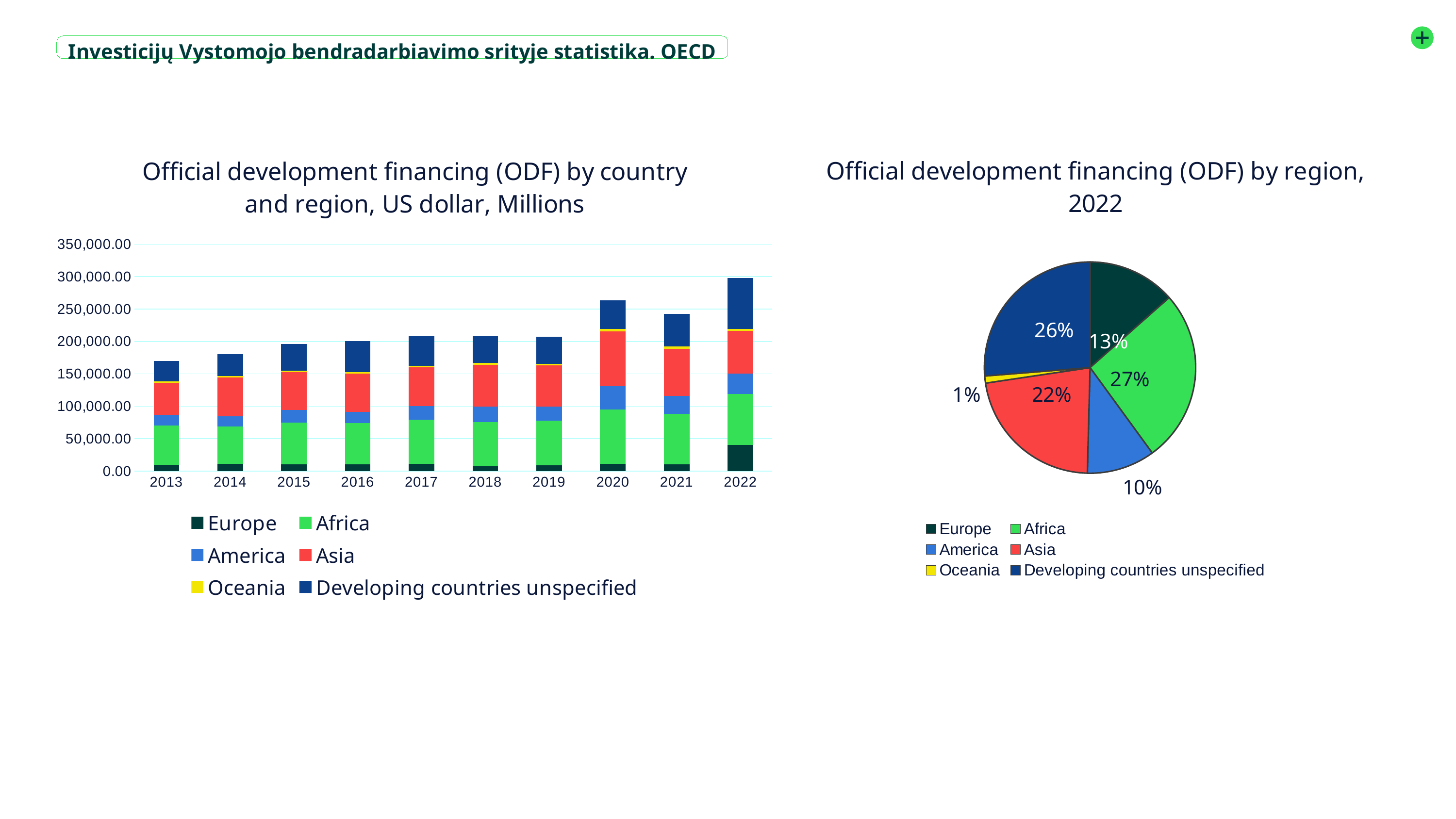
In the left bar chart, is the total stacked bar for 2013 greater or less than 200,000.00? less In the left bar chart, which year has the shortest stacked bar? 2013 In the right pie chart, what share does Developing countries unspecified have? 26% In the right pie chart, which is larger, the share for Asia or the share for America? Asia In the left bar chart, which year has the tallest stacked bar? 2022 In the left bar chart, is the total stacked bar for 2022 greater or less than 250,000.00? greater In the right pie chart, what share does Africa have? 27% In the left bar chart, how many series does the legend list? 6 In the right pie chart, which region has the smallest share? Oceania What type of chart is the right chart, 'Official development financing (ODF) by region, 2022'? pie chart What type of chart is the left chart, 'Official development financing (ODF) by country and region, US dollar, Millions'? stacked bar chart In the left bar chart, how many years are shown on the x axis? 10